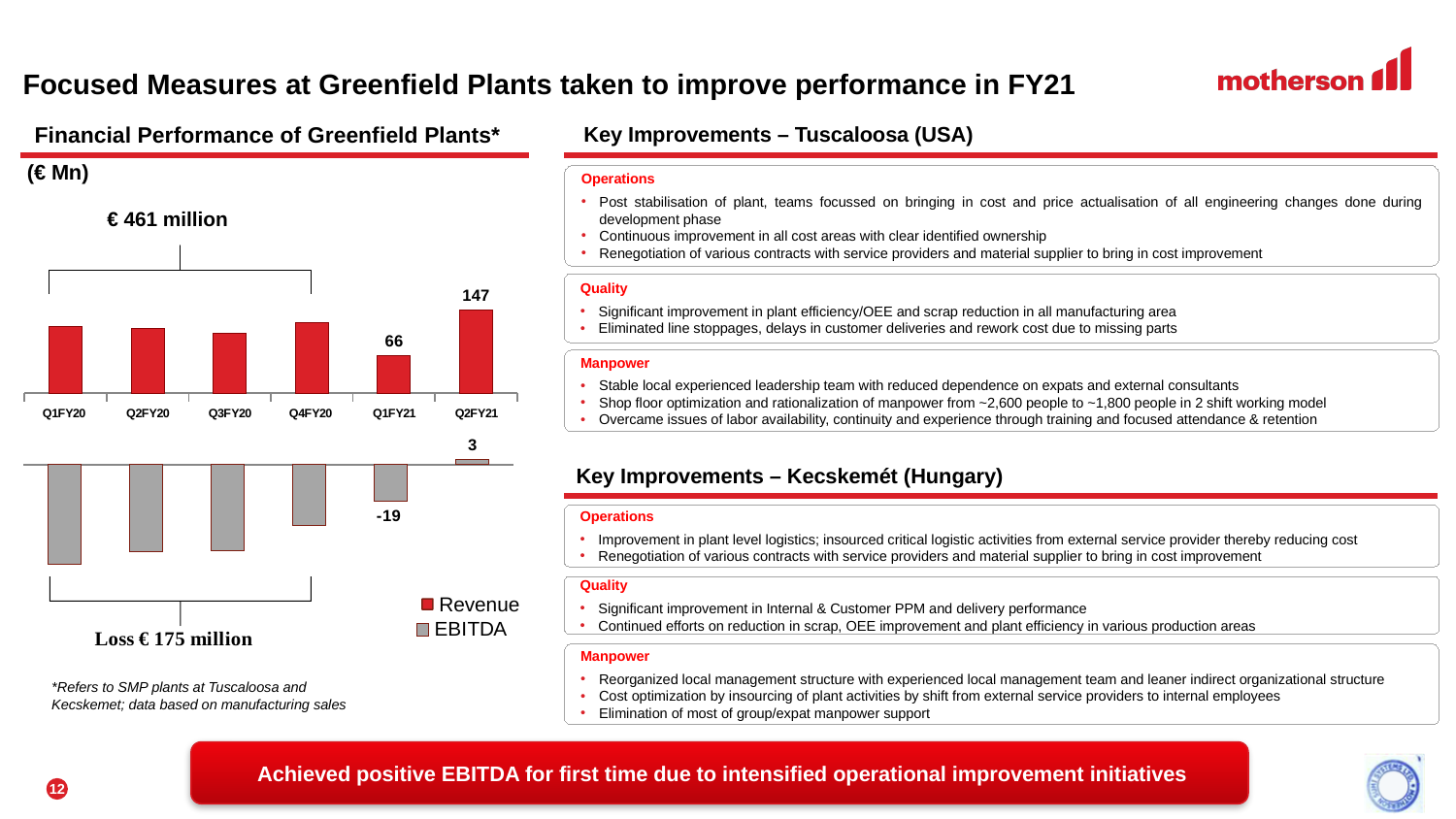
What is the EBITDA value for Q1FY21? -19 How many series does the chart legend list? 2 What is the Revenue value for Q2FY21? 147 Which quarter has the lowest Revenue? Q1FY21 What is the Revenue value for Q1FY21? 66 What is the difference between the EBITDA values for Q2FY21 and Q1FY21? 22 Which quarter has the highest EBITDA? Q2FY21 Which quarter has the highest Revenue? Q2FY21 By how much did Revenue increase from Q1FY21 to Q2FY21? 81 What is the EBITDA value for Q2FY21? 3 How many quarters are shown on the x axis of the chart? 6 What type of chart is used to show the Financial Performance of Greenfield Plants? Bar chart